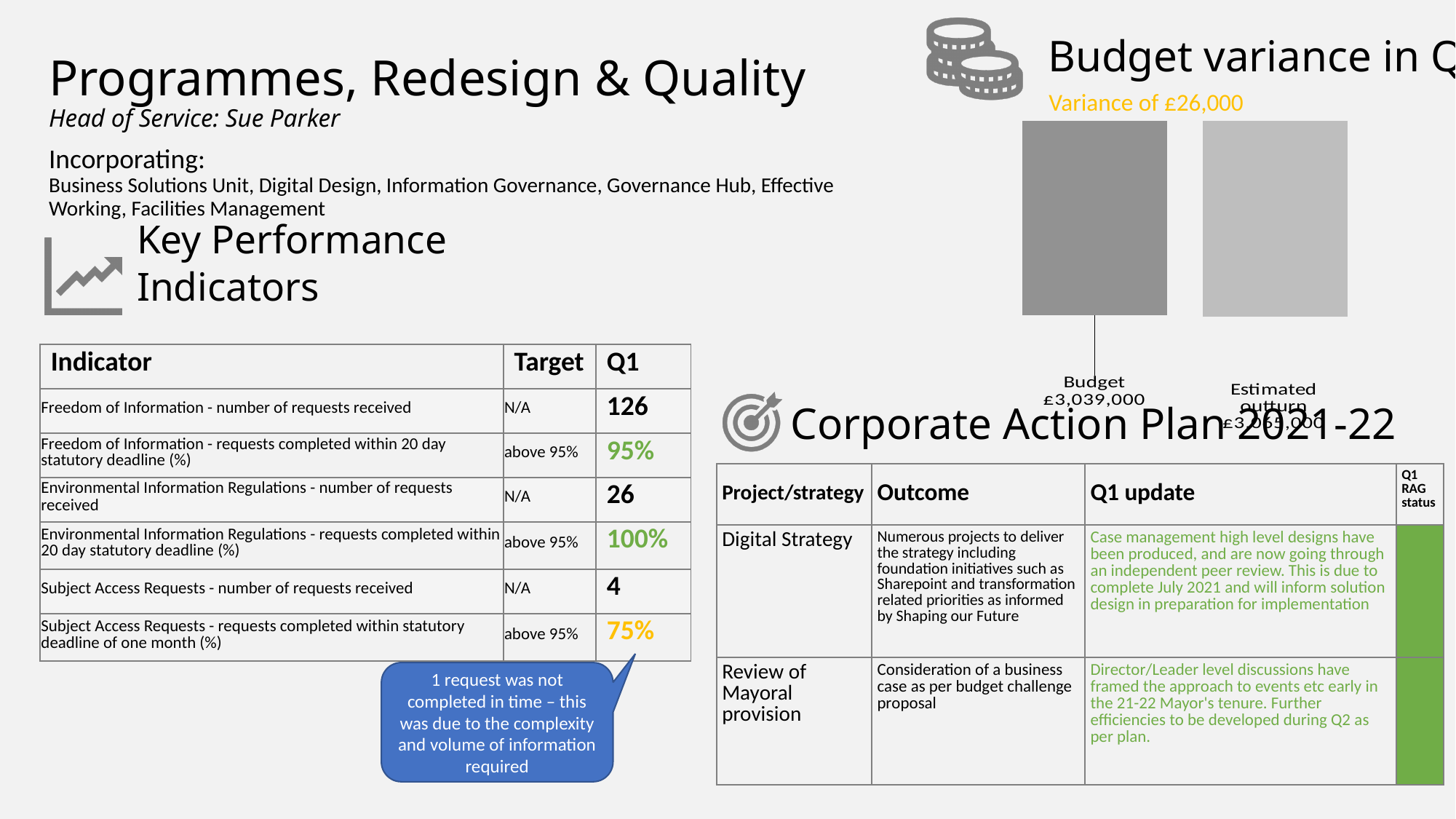
In the budget variance chart, which is larger, the Budget or the Estimated outturn? Estimated outturn In the budget variance chart, what is the value of the Budget bar? £3,039,000 What variance amount is stated above the budget variance chart? Variance of £26,000 How many bars does the budget variance chart show? 2 What kind of chart is shown under the 'Budget variance' heading? bar chart In the budget variance chart, what is the difference between the Estimated outturn and the Budget? £26,000 In the budget variance chart, what is the value of the Estimated outturn bar? £3,065,000 In the budget variance chart, which bar is drawn in the darker grey, Budget or Estimated outturn? Budget